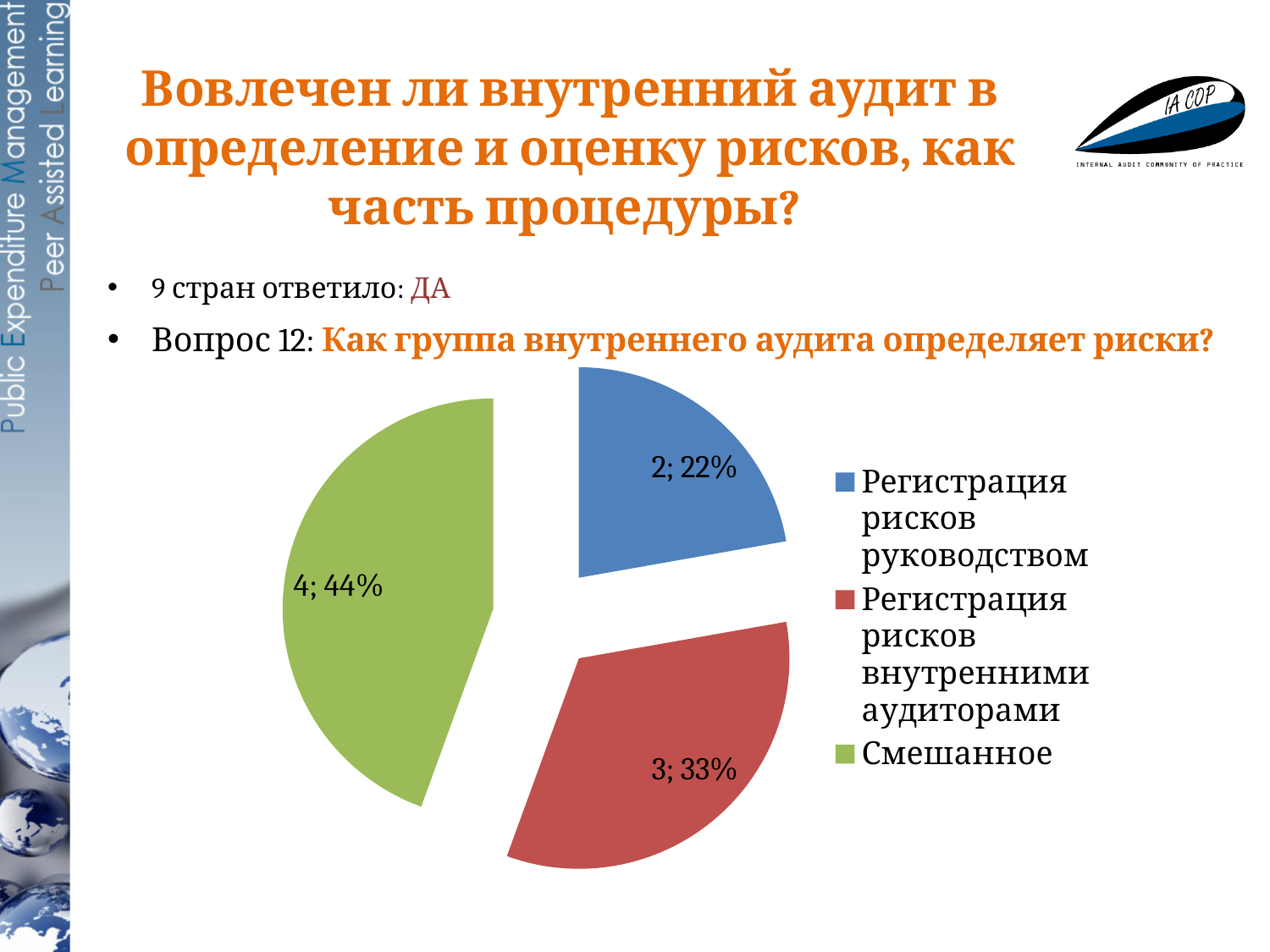
What share of the pie does "Смешанное" take? 44% What is the total of all slice values in the pie chart? 9 Which is larger: "Регистрация рисков внутренними аудиторами" or "Регистрация рисков руководством"? Регистрация рисков внутренними аудиторами What is the difference between the values for "Смешанное" and "Регистрация рисков руководством"? 2 How many slices does the pie chart have? 3 What share of the pie does "Регистрация рисков внутренними аудиторами" take? 33% What colour is the slice for "Смешанное"? green What is the value for "Регистрация рисков руководством"? 2 Which category has the largest slice? Смешанное Which category has the smallest slice? Регистрация рисков руководством What kind of chart is shown on the slide? pie chart What is the value for "Смешанное"? 4